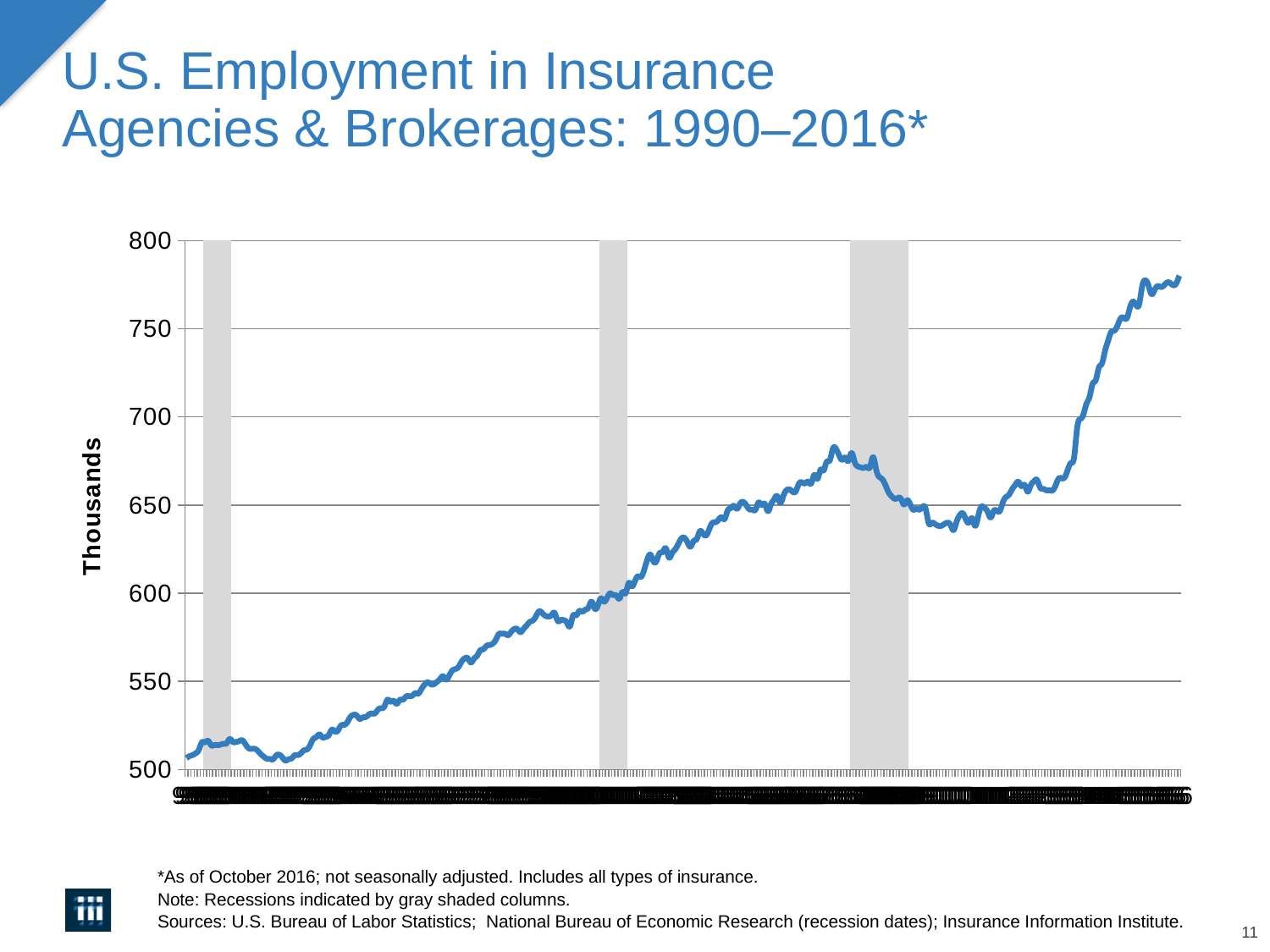
Where along the series does the line reach its highest value? at the end of the series How many gray shaded recession columns appear on the chart? 3 According to the note on the slide, what do the gray shaded columns indicate? Recessions What is the label on the vertical axis of the chart? Thousands Is the value at the start of the series (1990) greater or less than 550? less Where along the series does the line reach its lowest value? near the start of the series Is the lowest value reached after the third gray shaded recession greater or less than 650? less Is the value at the end of the series (October 2016) greater or less than 750? greater Overall, does employment in insurance agencies and brokerages rise or fall from the start of the series to the end? rise How many lines are plotted on the chart? 1 What kind of chart is shown on the slide? line chart